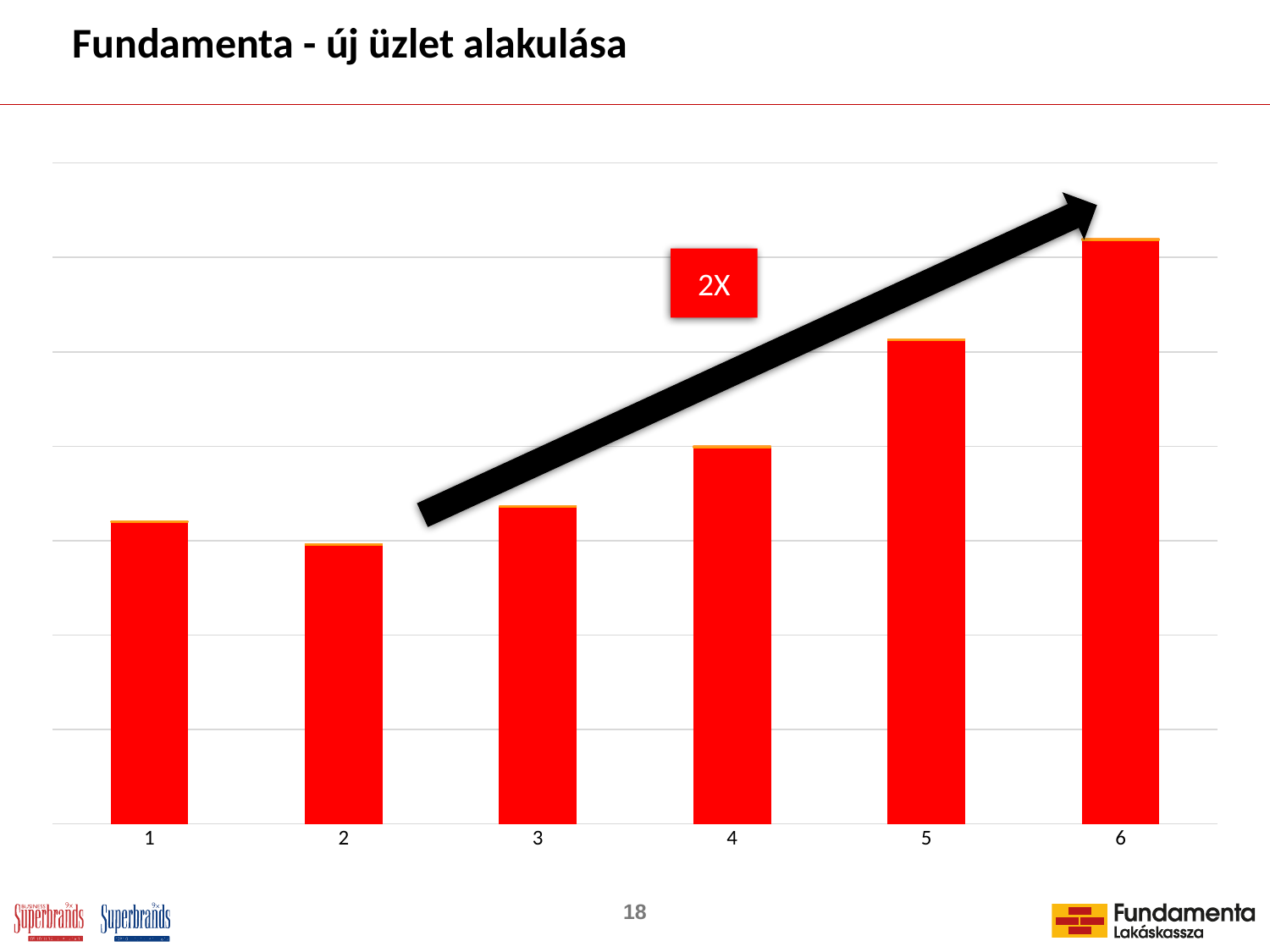
What is the title of the slide containing the chart? Fundamenta - új üzlet alakulása Which is larger, the value for category 1 or the value for category 2? 1 Which is larger, the value for category 4 or the value for category 6? 6 Do the bar values generally rise or fall from category 2 to category 6? rise What text is shown in the red box next to the arrow on the chart? 2X What kind of chart is shown on the slide? bar chart How many bars (categories) does the chart show? 6 Which category has the highest bar? 6 Which category has the lowest bar? 2 Which is larger, the value for category 5 or the value for category 3? 5